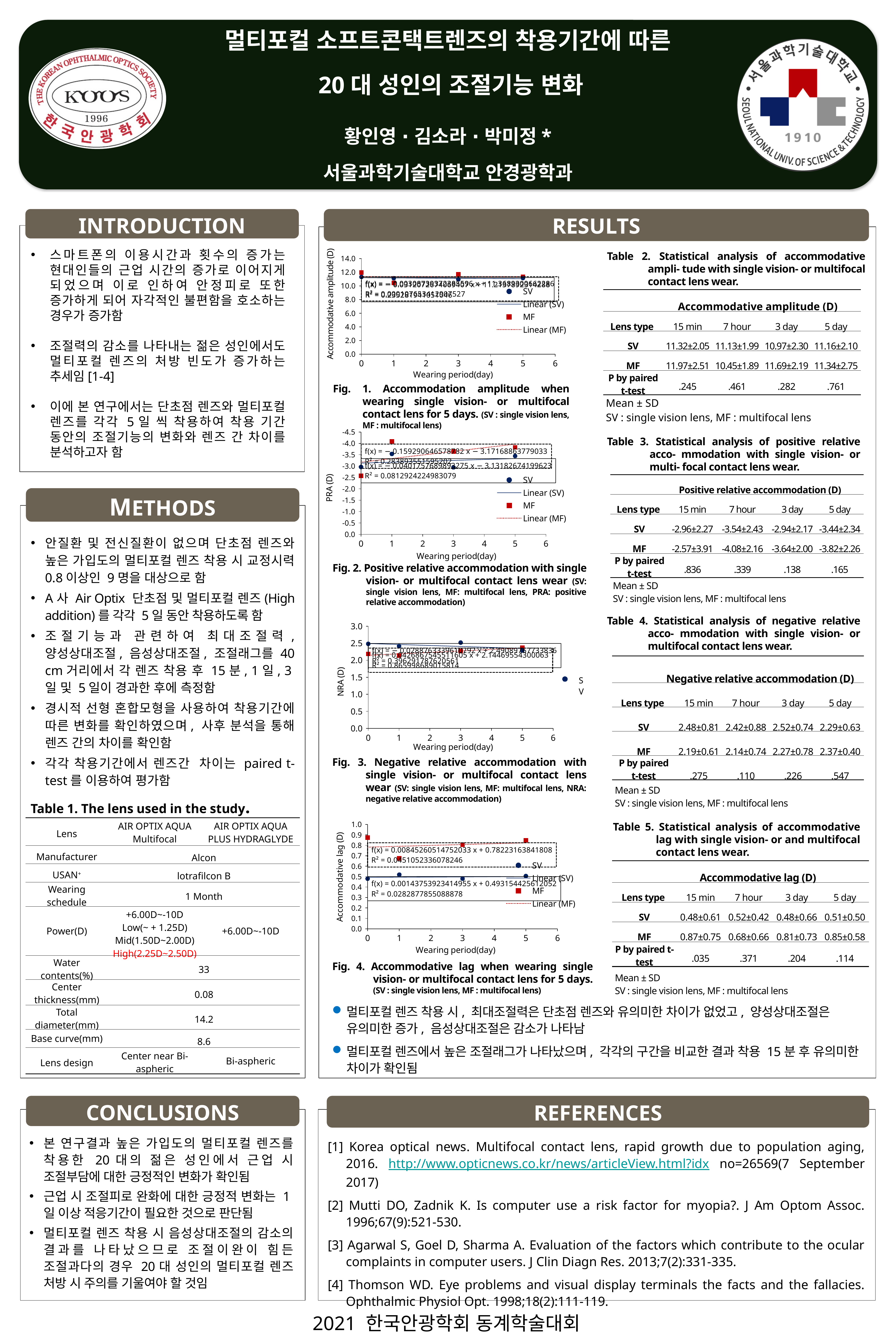
In Fig. 3 (Negative relative accommodation), is the SV value at wearing period 0 greater or less than 2.0? greater In Fig. 1 (Accommodation amplitude), what is the x-axis label? Wearing period(day) In Fig. 4 (Accommodative lag), is the MF value at wearing period 0 greater or less than 0.8? greater In Fig. 4 (Accommodative lag), how many data points are plotted for the MF series? 4 In Fig. 4 (Accommodative lag), at wearing period 5 days, which series has the higher value, SV or MF? MF In Fig. 1 (Accommodation amplitude), how many entries does the legend list? 4 In Fig. 1 (Accommodation amplitude), is the MF value at wearing period 0 greater or less than 10.0? greater In Fig. 2 (Positive relative accommodation), what is the y-axis label? PRA (D) What kind of chart is Fig. 1 (Accommodation amplitude)? scatter chart In Fig. 1 (Accommodation amplitude), at wearing period 1 day, which series has the higher value, SV or MF? SV